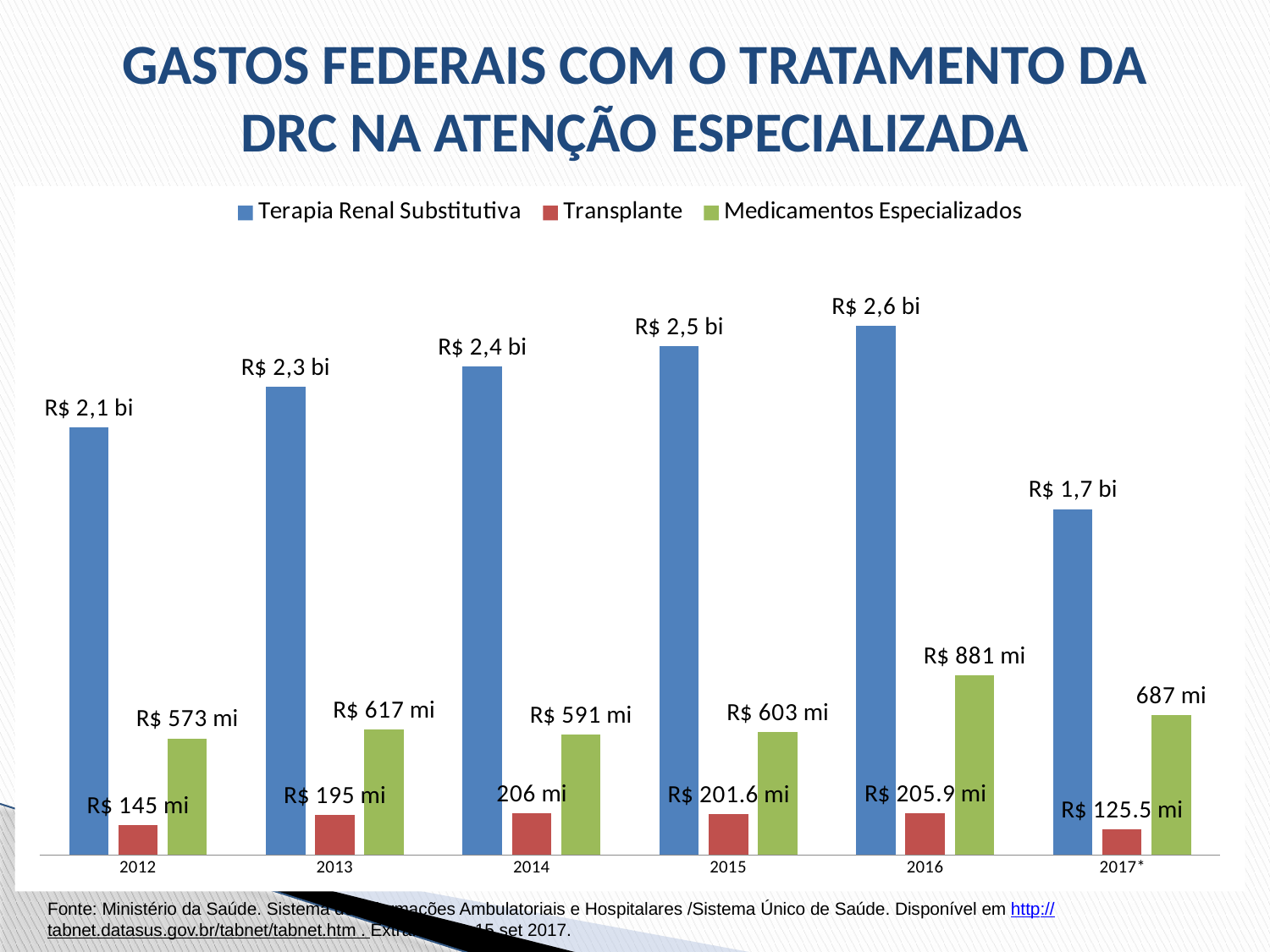
What is the difference between the Medicamentos Especializados values for 2016 and 2015? R$ 278 mi Which series is shown in green in the legend? Medicamentos Especializados What is the value for Transplante in 2015? R$ 201.6 mi Does the Terapia Renal Substitutiva value rise or fall from 2012 to 2016? rise How many years are shown on the x axis? 6 In which year is the Transplante value lowest? 2017* What is the value for Terapia Renal Substitutiva in 2014? R$ 2,4 bi What is the value for Medicamentos Especializados in 2016? R$ 881 mi How many series does the legend list? 3 In which year is the Terapia Renal Substitutiva value highest? 2016 Which is larger, the Medicamentos Especializados value in 2013 or in 2014? 2013 What kind of chart is shown on the slide? bar chart